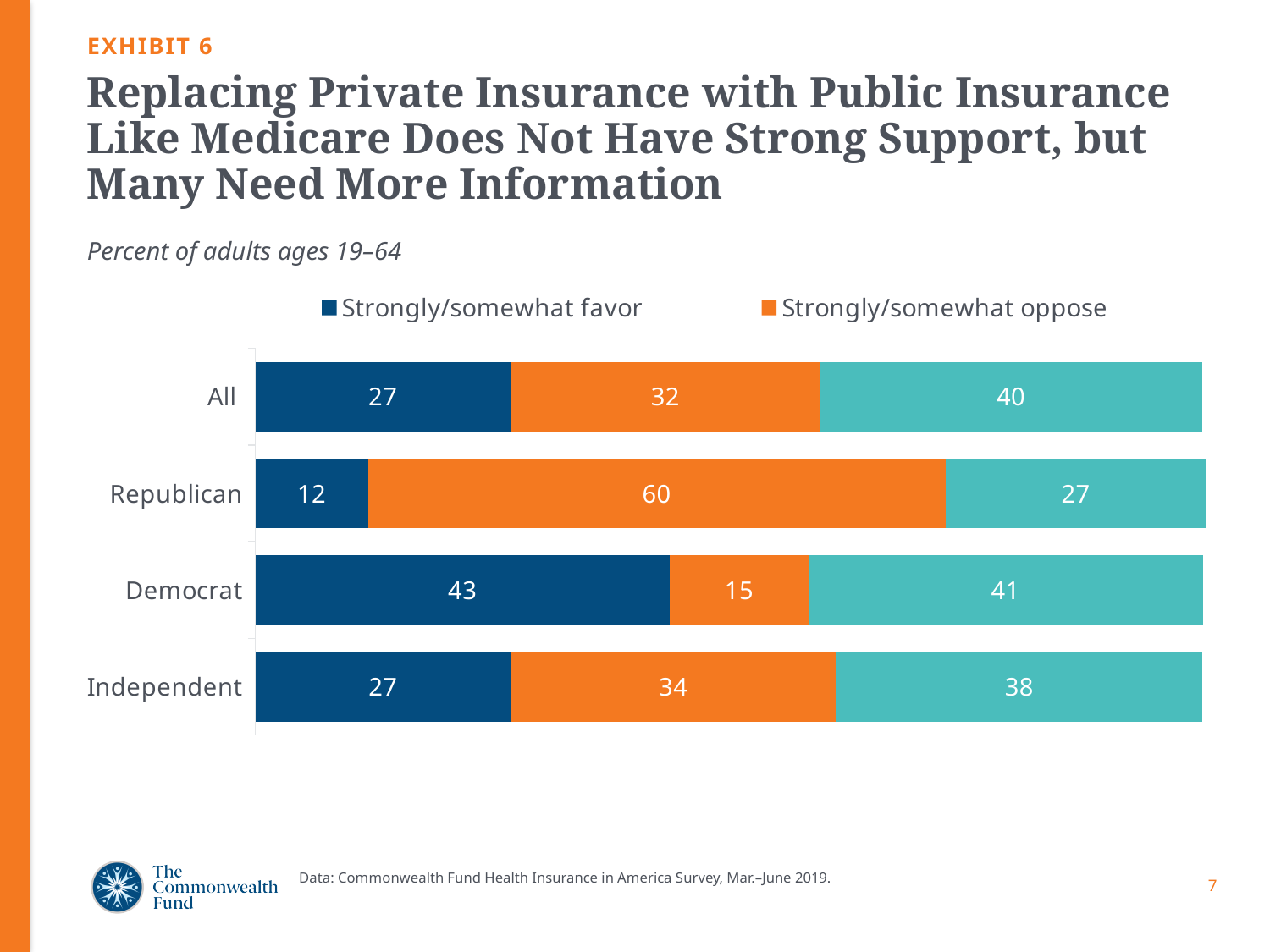
What percent of Democrats strongly/somewhat oppose replacing private insurance with public insurance? 15 What is the total of the three segments in the Democrat bar? 99 How many series does the legend list? 2 What is the Strongly/somewhat oppose value for All adults? 32 What percent of Republicans strongly/somewhat favor replacing private insurance with public insurance? 12 What is the difference between the Strongly/somewhat favor values for Democrats and Republicans? 31 Which group has the highest Strongly/somewhat oppose value? Republican Which is larger for Independents: the Strongly/somewhat favor value or the Strongly/somewhat oppose value? Strongly/somewhat oppose How many groups are shown on the chart? 4 Which group has the lowest Strongly/somewhat favor value? Republican What kind of chart is shown on the slide? Stacked bar chart What is the Strongly/somewhat favor value for Independents? 27